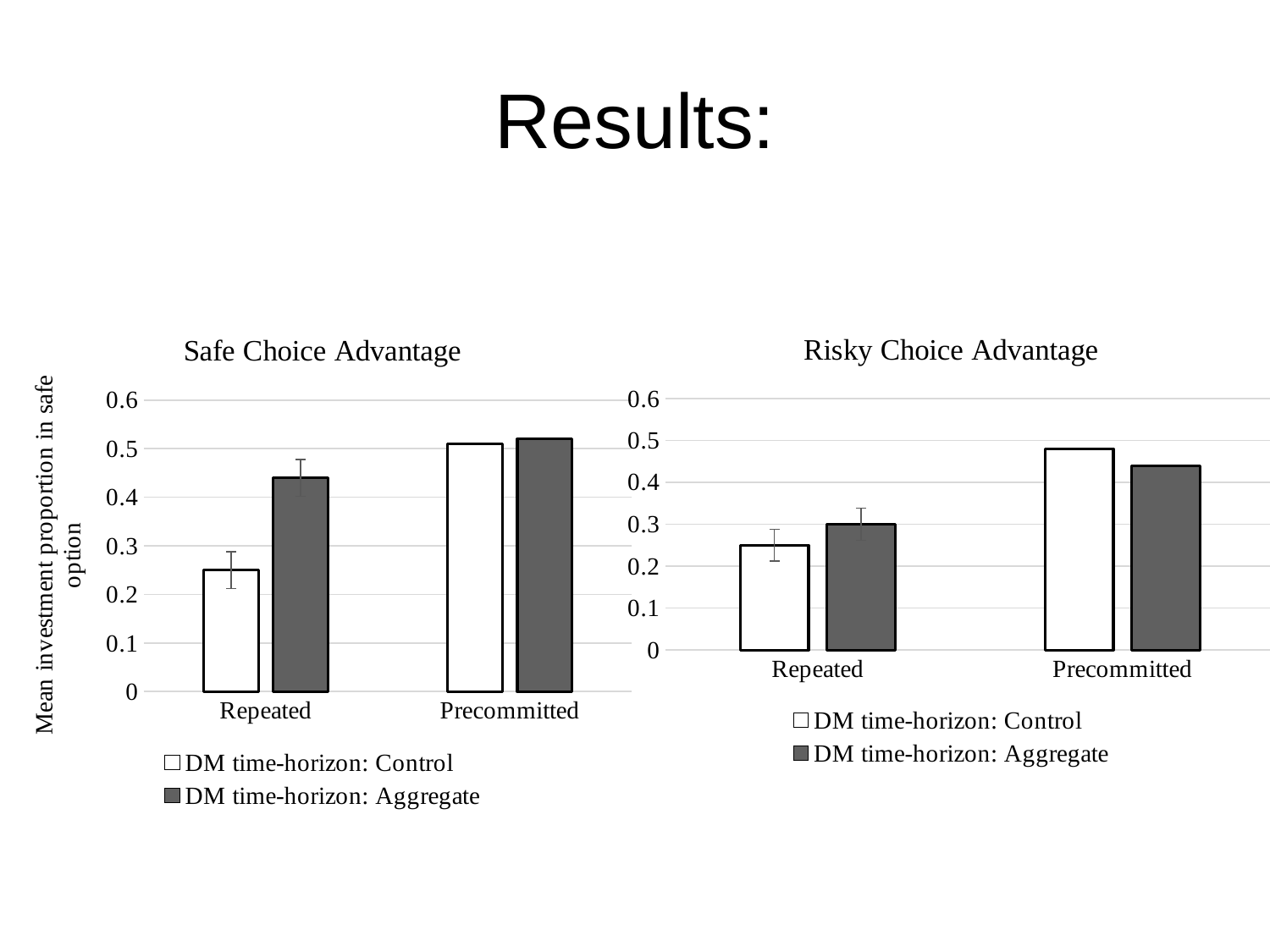
How many categories are shown on the x axis of the Safe Choice Advantage chart? 2 In the Risky Choice Advantage chart, is the value for DM time-horizon: Control in the Precommitted condition greater or less than 0.4? greater In the Risky Choice Advantage chart, is the value for DM time-horizon: Aggregate in the Precommitted condition greater or less than 0.5? less In the Risky Choice Advantage chart, which series has the larger value in the Precommitted condition? DM time-horizon: Control What is the y-axis label of the Safe Choice Advantage chart? Mean investment proportion in safe option In the Safe Choice Advantage chart, is the value for DM time-horizon: Control in the Repeated condition greater or less than 0.3? less In the Safe Choice Advantage chart, which series has the larger value in the Repeated condition? DM time-horizon: Aggregate What type of chart is the Safe Choice Advantage chart? bar chart In the Safe Choice Advantage chart, does the DM time-horizon: Control series rise or fall from Repeated to Precommitted? rise In the Safe Choice Advantage chart, which bar is the lowest? DM time-horizon: Control, Repeated How many series does the legend of the Risky Choice Advantage chart list? 2